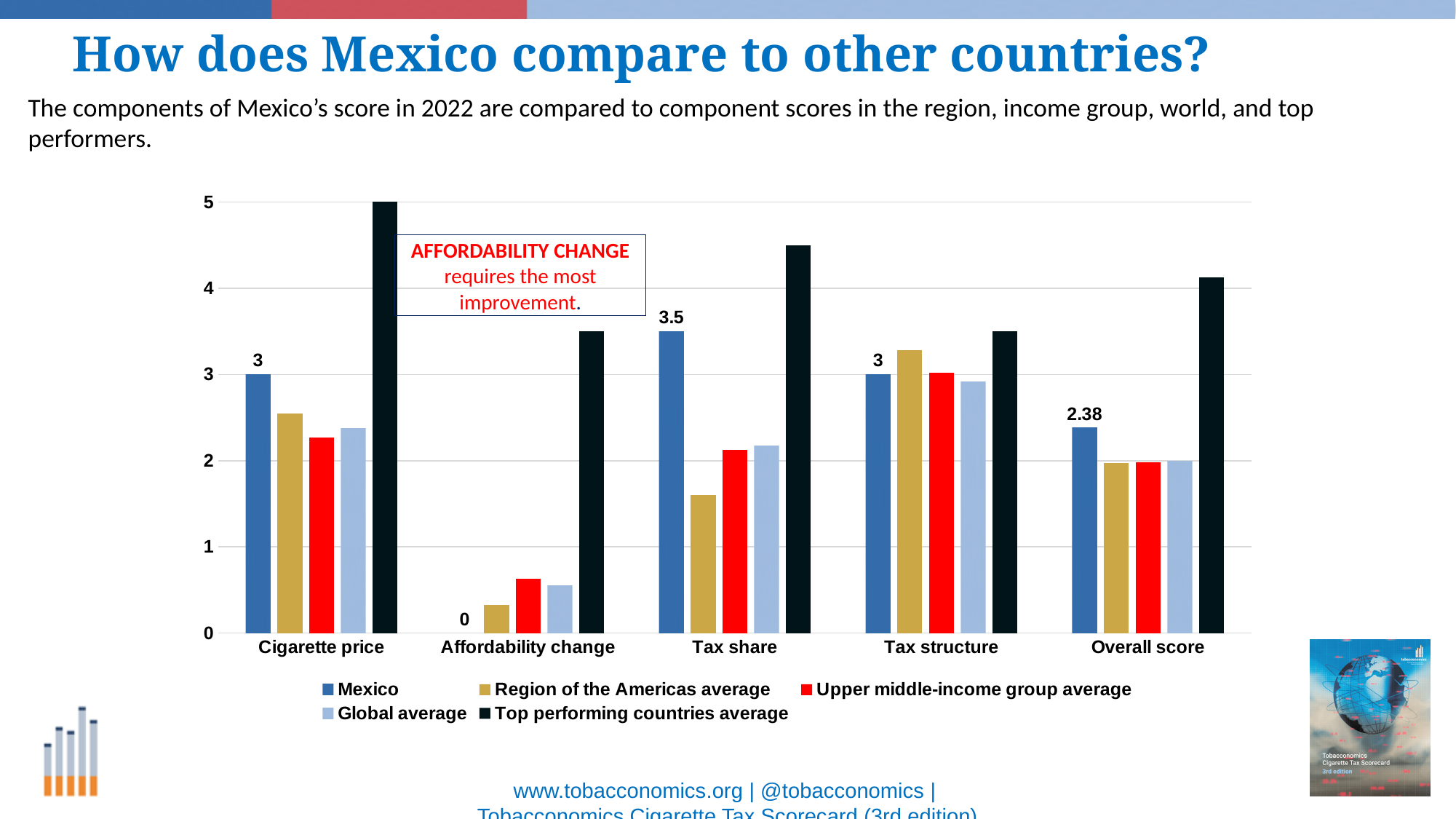
Which component has the highest score for Mexico? Tax share Is the Top performing countries average for Tax share greater or less than 4? greater How many series does the legend list? 5 Which component has the lowest score for Mexico? Affordability change Is the Region of the Americas average for Tax share greater or less than 2? less What is Mexico's Overall score? 2.38 How many categories are shown on the x axis? 5 What kind of chart is shown on the slide? Bar chart What is the difference between Mexico's Tax share score and its Overall score? 1.12 What is Mexico's score for Affordability change? 0 What is Mexico's score for Tax share? 3.5 What is Mexico's score for Cigarette price? 3